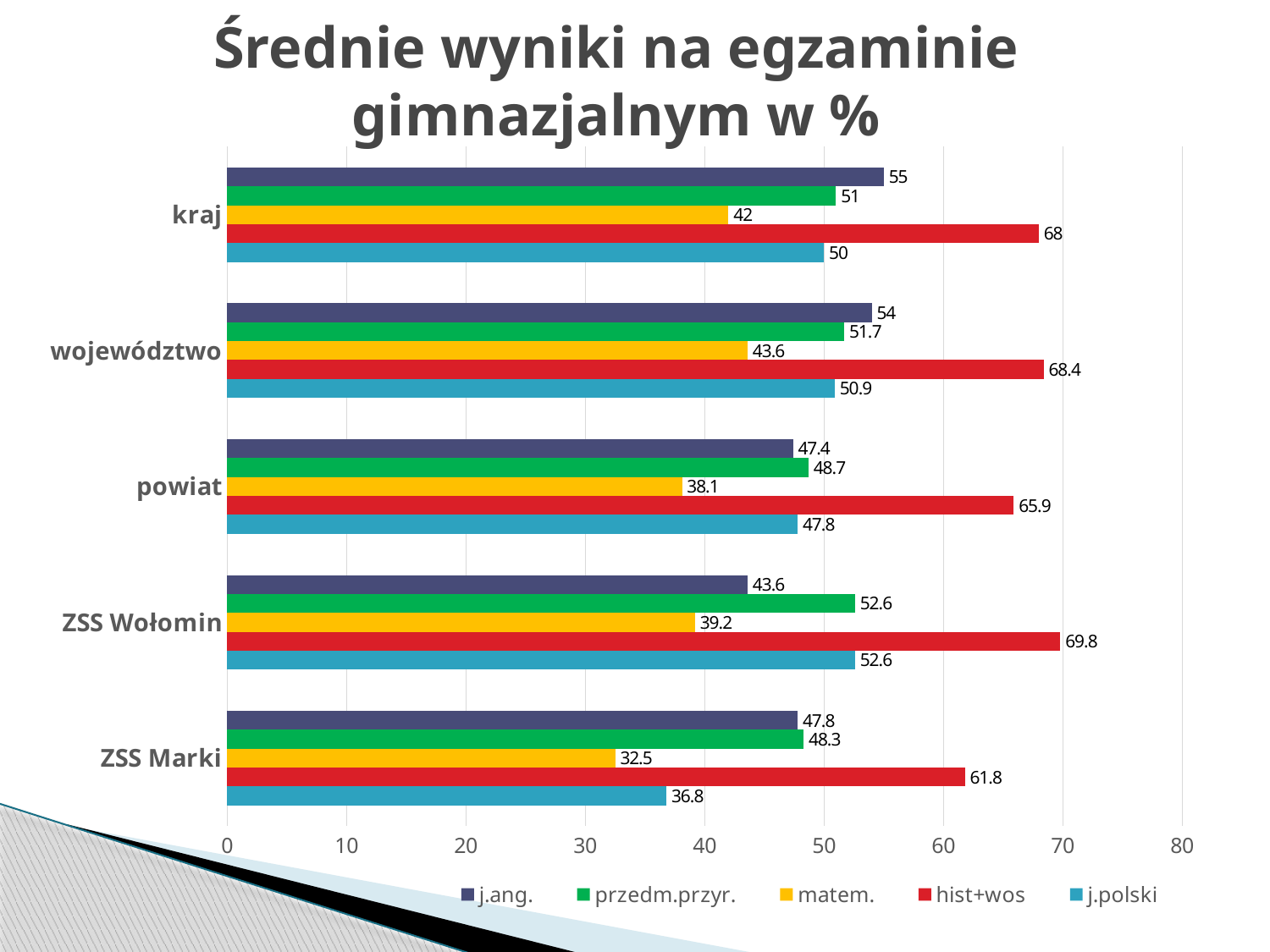
What is the hist+wos value for ZSS Wołomin? 69.8 What is the j.ang. value for kraj? 55 Which category has the highest hist+wos value? ZSS Wołomin What is the difference between the hist+wos value and the matem. value for powiat? 27.8 What is the matem. value for ZSS Marki? 32.5 What kind of chart is shown on the slide? bar chart Which is larger for ZSS Marki: the j.ang. value or the j.polski value? j.ang. How many categories are shown on the vertical axis? 5 Which category has the lowest matem. value? ZSS Marki How many series does the legend list? 5 What is the title of the chart? Średnie wyniki na egzaminie gimnazjalnym w % What is the j.polski value for województwo? 50.9